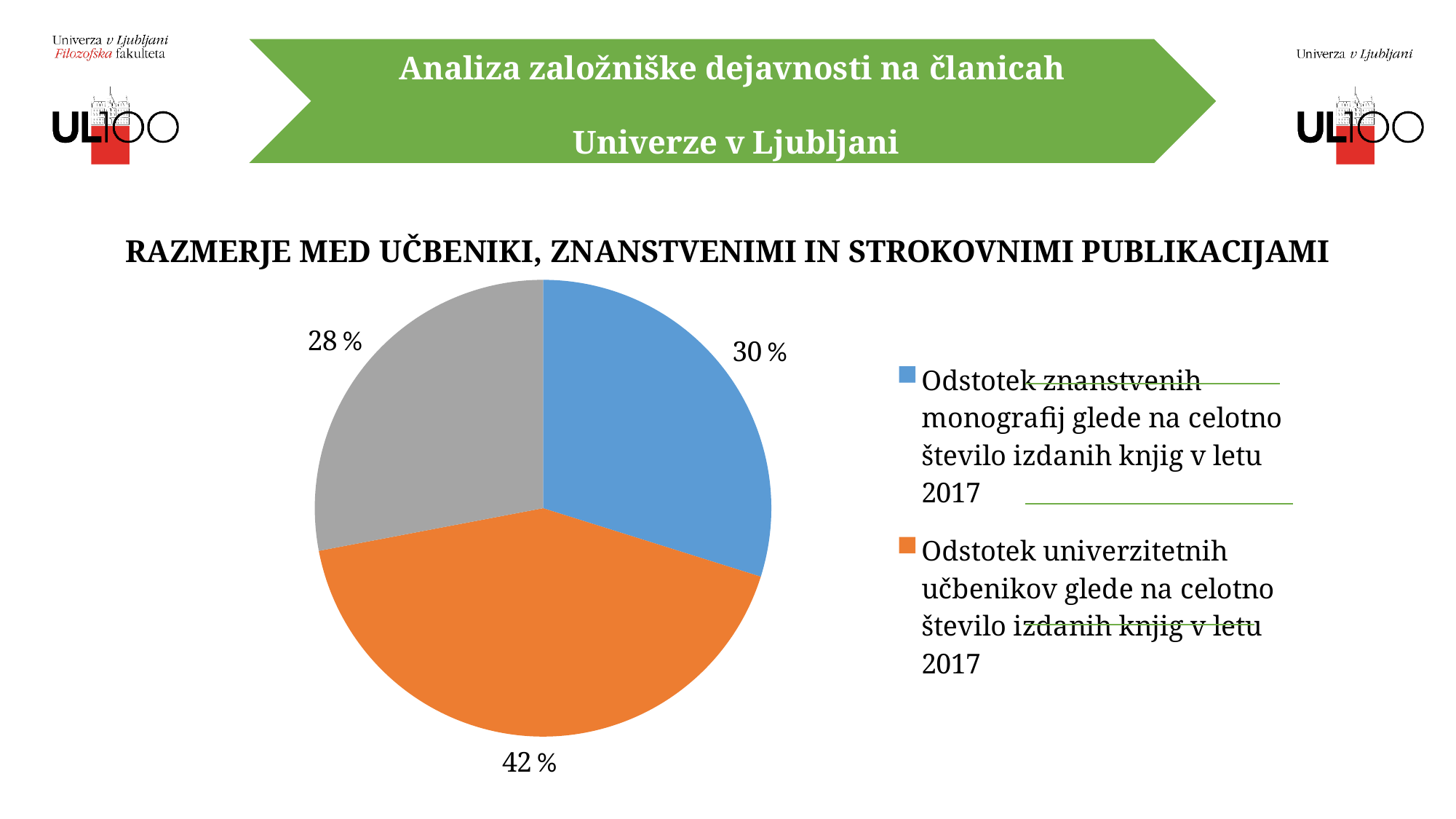
What is the smallest value shown on the pie chart? 28 % How many entries does the chart legend list? 2 Which slice of the pie chart is the largest? Odstotek univerzitetnih učbenikov glede na celotno število izdanih knjig v letu 2017 What value is shown on the grey slice of the pie chart? 28 % What kind of chart is shown on the slide? pie chart Which is larger: the share for znanstvenih monografij or the share for univerzitetnih učbenikov? univerzitetnih učbenikov How many slices does the pie chart have? 3 What share of the pie is labelled for 'Odstotek znanstvenih monografij glede na celotno število izdanih knjig v letu 2017'? 30 % What share of the pie is labelled for 'Odstotek univerzitetnih učbenikov glede na celotno število izdanih knjig v letu 2017'? 42 % What is the difference between the orange slice (42 %) and the blue slice (30 %)? 12 % What is the title of the chart? RAZMERJE MED UČBENIKI, ZNANSTVENIMI IN STROKOVNIMI PUBLIKACIJAMI What colour is the slice representing 'Odstotek znanstvenih monografij glede na celotno število izdanih knjig v letu 2017'? blue